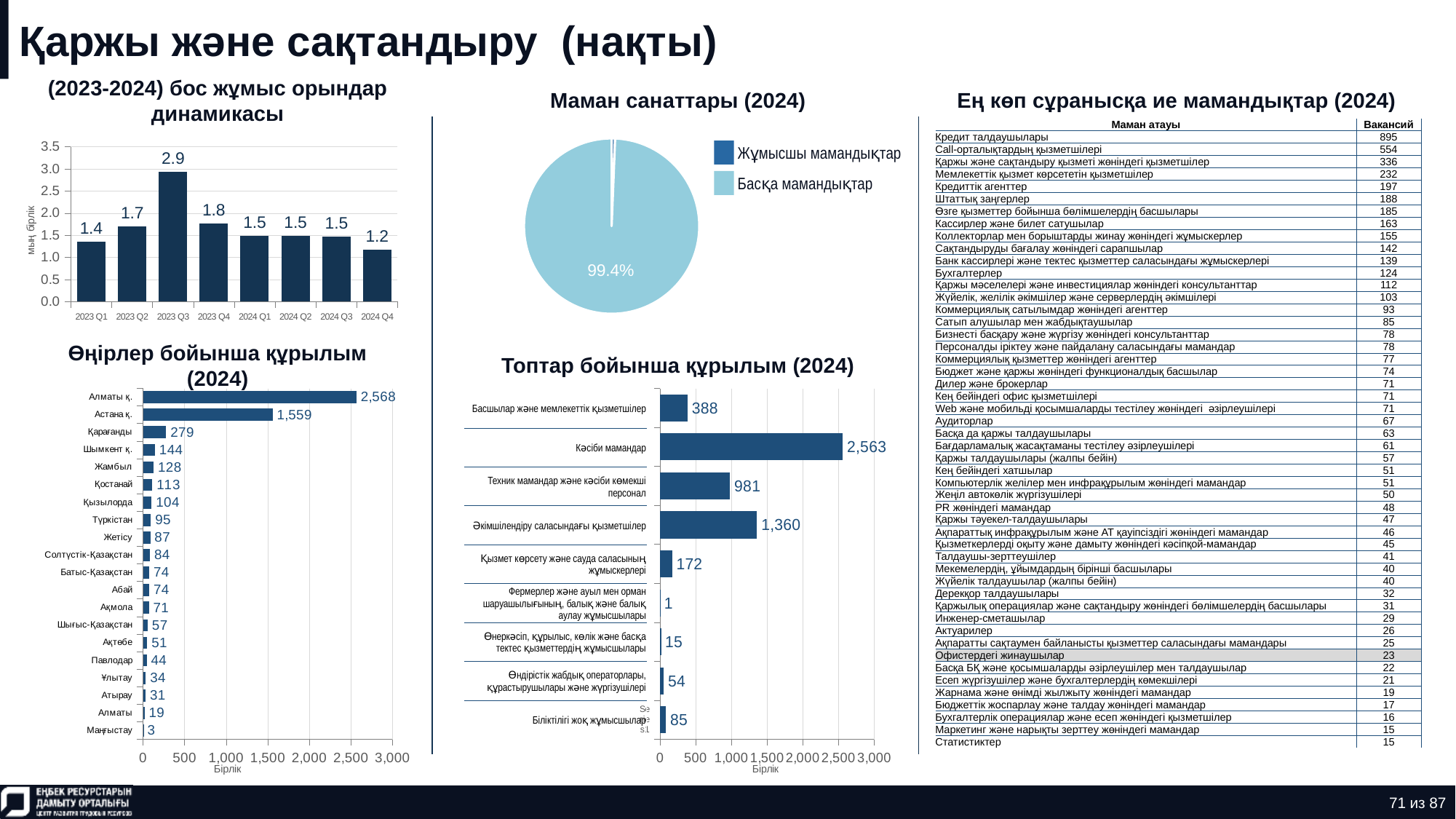
What kind of chart is "Топтар бойынша құрылым (2024)"? Bar chart In the chart titled "Топтар бойынша құрылым (2024)", what is the value for Кәсіби мамандар? 2,563 In the chart titled "Өңірлер бойынша құрылым (2024)", what is the value for Астана қ.? 1,559 In the chart titled "(2023-2024) бос жұмыс орындар динамикасы", what is the value for 2023 Q3? 2.9 In the pie chart titled "Маман санаттары (2024)", what share is shown for the large slice? 99.4% In the chart titled "(2023-2024) бос жұмыс орындар динамикасы", what is the difference between the values for 2023 Q3 and 2023 Q4? 1.1 In the chart titled "Өңірлер бойынша құрылым (2024)", which region has the highest value? Алматы қ. In the chart titled "(2023-2024) бос жұмыс орындар динамикасы", which quarter has the lowest value? 2024 Q4 In the chart titled "(2023-2024) бос жұмыс орындар динамикасы", how many quarters are plotted? 8 In the pie chart titled "Маман санаттары (2024)", how many entries does the legend list? 2 In the chart titled "Топтар бойынша құрылым (2024)", which is larger: the value for Техник мамандар және кәсіби көмекші персонал or the value for Әкімшілендіру саласындағы қызметшілер? Әкімшілендіру саласындағы қызметшілер In the chart titled "Өңірлер бойынша құрылым (2024)", what is the difference between the values for Алматы қ. and Астана қ.? 1,009